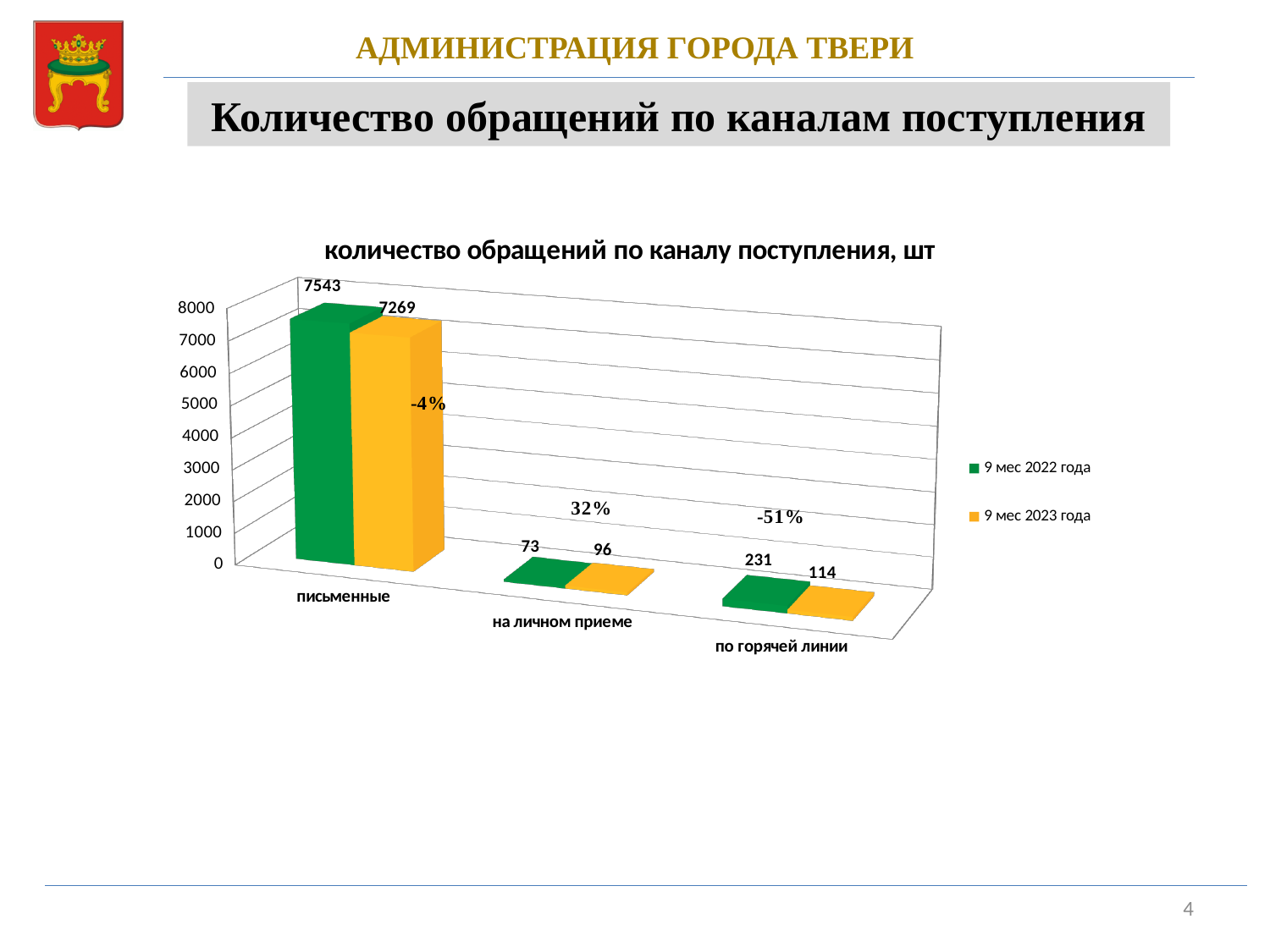
How many categories are shown on the x axis? 3 How many series does the legend list? 2 What is the value for на личном приеме in the 9 мес 2023 года series? 96 Which is larger for на личном приеме: the 9 мес 2022 года value or the 9 мес 2023 года value? 9 мес 2023 года What is the value for письменные in the 9 мес 2022 года series? 7543 What is the value for по горячей линии in the 9 мес 2022 года series? 231 Which category has the lowest value in the 9 мес 2023 года series? на личном приеме What is the value for письменные in the 9 мес 2023 года series? 7269 What is the title of the chart? количество обращений по каналу поступления, шт What kind of chart is shown on the slide? bar chart What is the difference between the 9 мес 2022 года and 9 мес 2023 года values for по горячей линии? 117 Which category has the highest value in the 9 мес 2022 года series? письменные